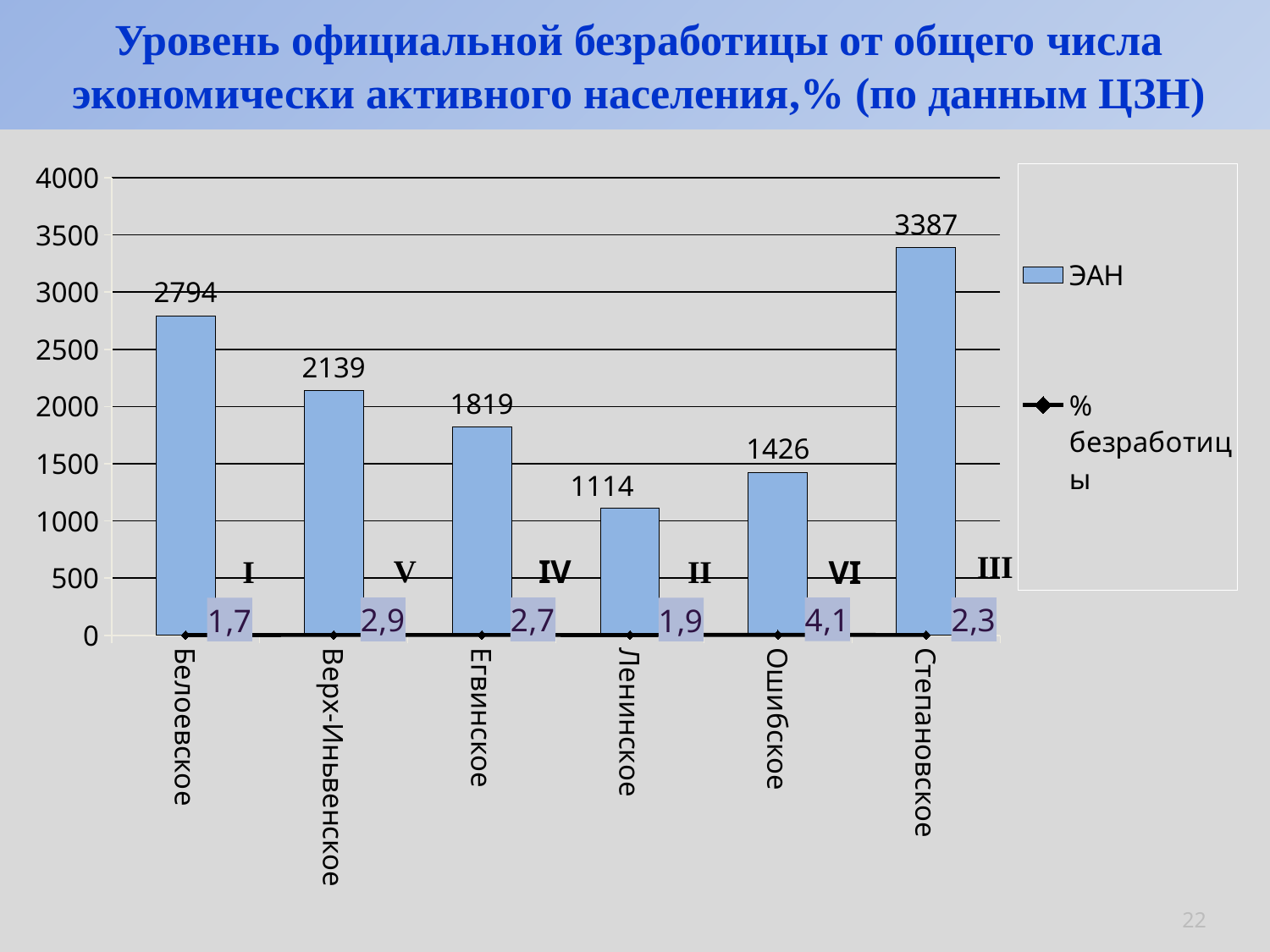
What is the difference between the ЭАН values for Белоевское and Верх-Иньвенское? 655 What kind of chart is used for the ЭАН series? Bar chart How many categories are shown on the x axis? 6 What is the ЭАН value for Степановское? 3387 Which has a larger ЭАН value, Егвинское or Ошибское? Егвинское What is the ЭАН value for Ленинское? 1114 How many series does the legend list? 2 Which category has the lowest % безработицы value? Белоевское What is the % безработицы value for Ошибское? 4,1 What is the % безработицы value for Белоевское? 1,7 Which category has the highest ЭАН value? Степановское What is the % безработицы value for Верх-Иньвенское? 2,9